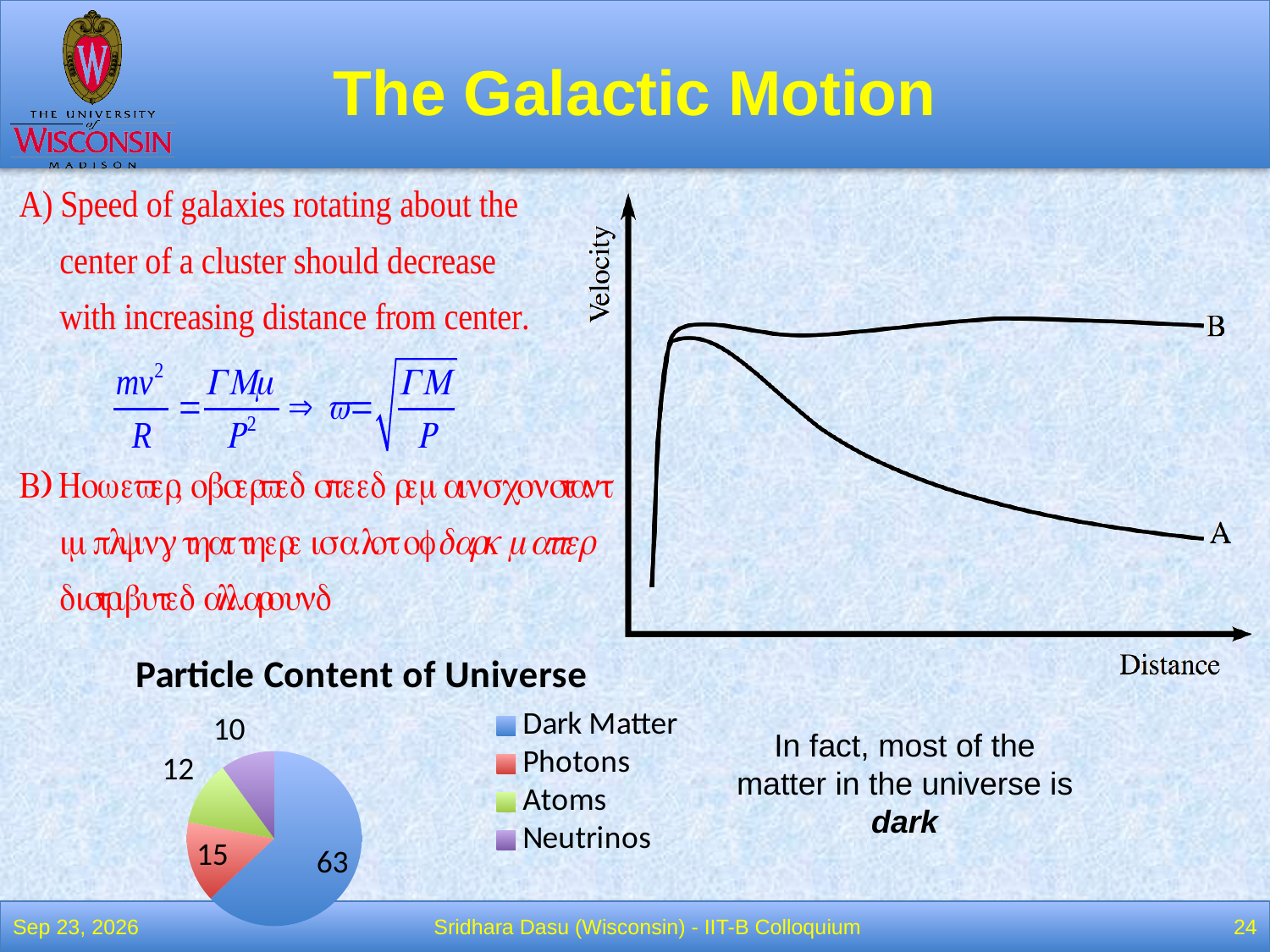
In the 'Particle Content of Universe' chart, which category has the largest slice? Dark Matter In the 'Particle Content of Universe' chart, what is the value for Atoms? 12 In the 'Particle Content of Universe' chart, what share of the whole pie does Dark Matter represent? 63% In the 'Particle Content of Universe' chart, what is the value for Photons? 15 In the 'Particle Content of Universe' chart, what is the value for Dark Matter? 63 What kind of chart is 'Particle Content of Universe'? Pie chart In the 'Particle Content of Universe' chart, which category has the smallest slice? Neutrinos In the 'Particle Content of Universe' chart, which is larger, the value for Photons or the value for Atoms? Photons In the 'Particle Content of Universe' chart, which colour represents Atoms in the legend? Green How many categories does the 'Particle Content of Universe' pie chart show? 4 In the 'Particle Content of Universe' chart, what is the value for Neutrinos? 10 In the 'Particle Content of Universe' chart, what is the difference between the values for Dark Matter and Photons? 48